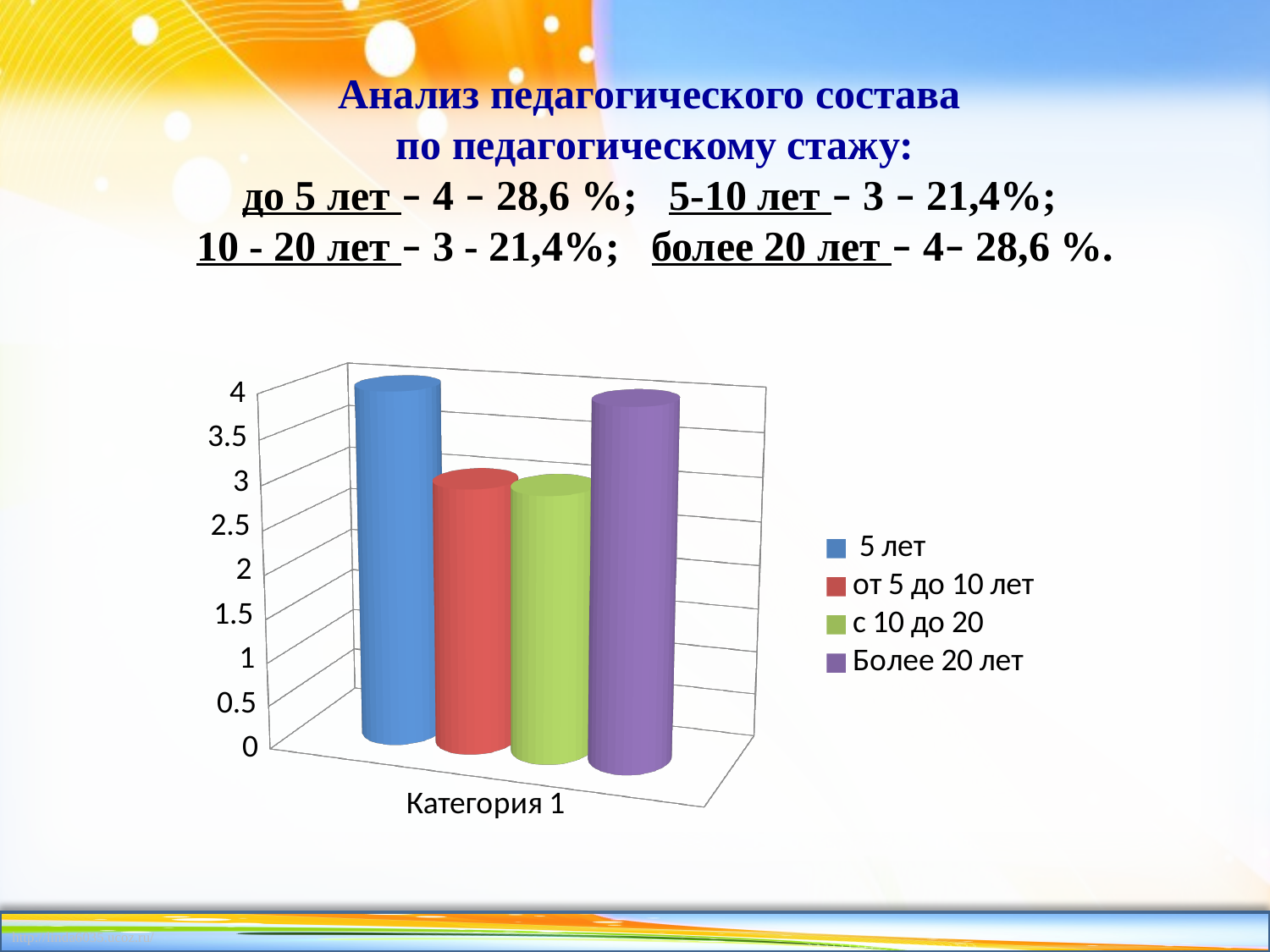
Which is larger in the chart, the value for '5 лет' or the value for 'от 5 до 10 лет'? 5 лет What is the difference between the value for 'Более 20 лет' and the value for 'с 10 до 20' in the chart? 1 Which is larger in the chart, the value for 'с 10 до 20' or the value for 'Более 20 лет'? Более 20 лет What is the value of the 'от 5 до 10 лет' series in the chart? 3 Which colour represents the 'Более 20 лет' series in the chart? purple What is the value of the '5 лет' series in the chart? 4 How many series does the chart legend list? 4 What is the label of the category on the x axis of the chart? Категория 1 Is the value for 'от 5 до 10 лет' in the chart greater or less than 3.5? less How many categories are shown on the x axis of the chart? 1 What kind of chart is shown on the slide? bar chart What is the value of the 'Более 20 лет' series in the chart? 4